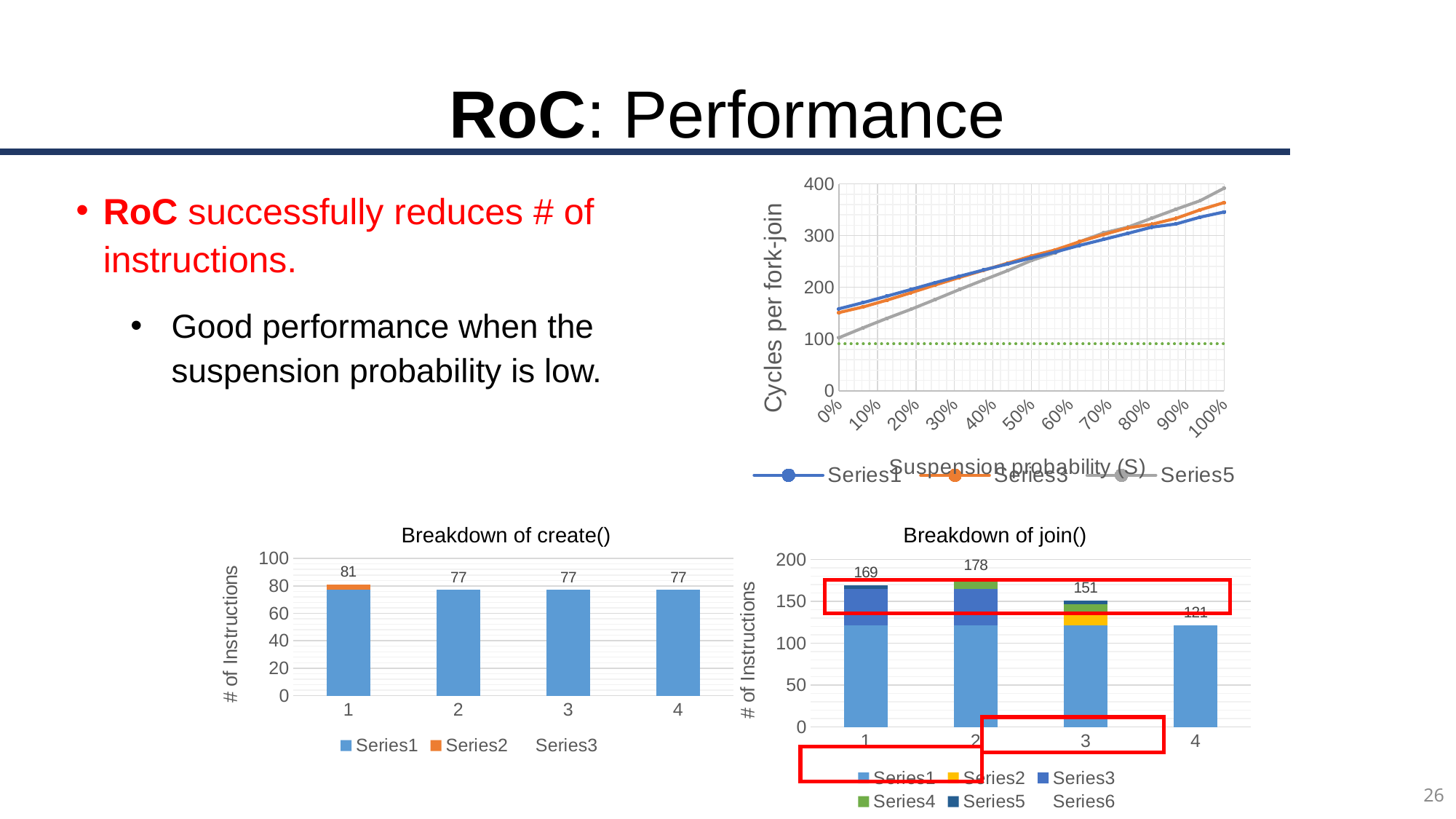
In the 'Breakdown of join()' chart, which category has the highest total? 2 In the top-right chart of cycles per fork-join, do the values for Series1 rise or fall as the suspension probability increases? rise In the 'Breakdown of join()' chart, what is the total value labeled for category 2? 178 In the 'Breakdown of create()' chart, which category has the highest total? 1 In the 'Breakdown of join()' chart, how many series does the legend list? 6 In the 'Breakdown of create()' chart, what is the total value labeled for category 1? 81 In the 'Breakdown of join()' chart, what is the difference between the totals for category 2 and category 4? 57 In the 'Breakdown of join()' chart, how many categories are shown on the x axis? 4 In the 'Breakdown of create()' chart, what is the difference between the totals for category 1 and category 2? 4 In the 'Breakdown of create()' chart, how many series does the legend list? 3 In the 'Breakdown of join()' chart, which category has the lowest total? 4 In the top-right chart of cycles per fork-join, is the value for Series1 at 100% greater or less than 400? less